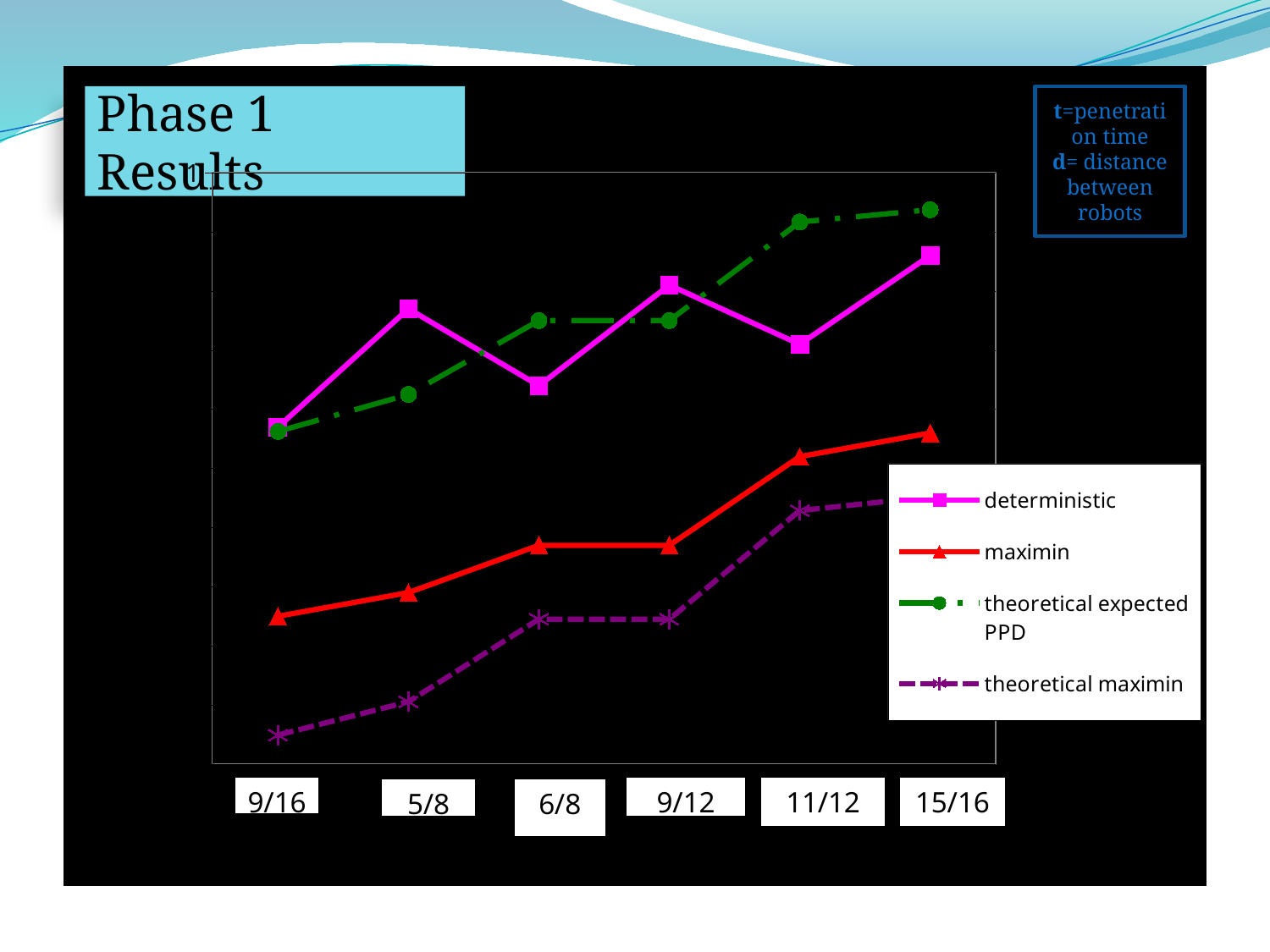
How many series does the legend list? 4 At 15/16, which is higher: theoretical expected PPD or deterministic? theoretical expected PPD What kind of chart is shown on the slide? line chart For the theoretical maximin series, which category has the lowest value? 9/16 For the deterministic series, which category has the highest value? 15/16 At 5/8, which is higher: deterministic or theoretical expected PPD? deterministic How many categories are shown along the x axis? 6 For the maximin series, which category has the highest value? 15/16 Which series is drawn with a dashed purple line? theoretical maximin At 9/16, which is higher: deterministic or maximin? deterministic Does the theoretical maximin series generally rise or fall along the x axis? rise Does the maximin series generally rise or fall from 9/16 to 15/16? rise